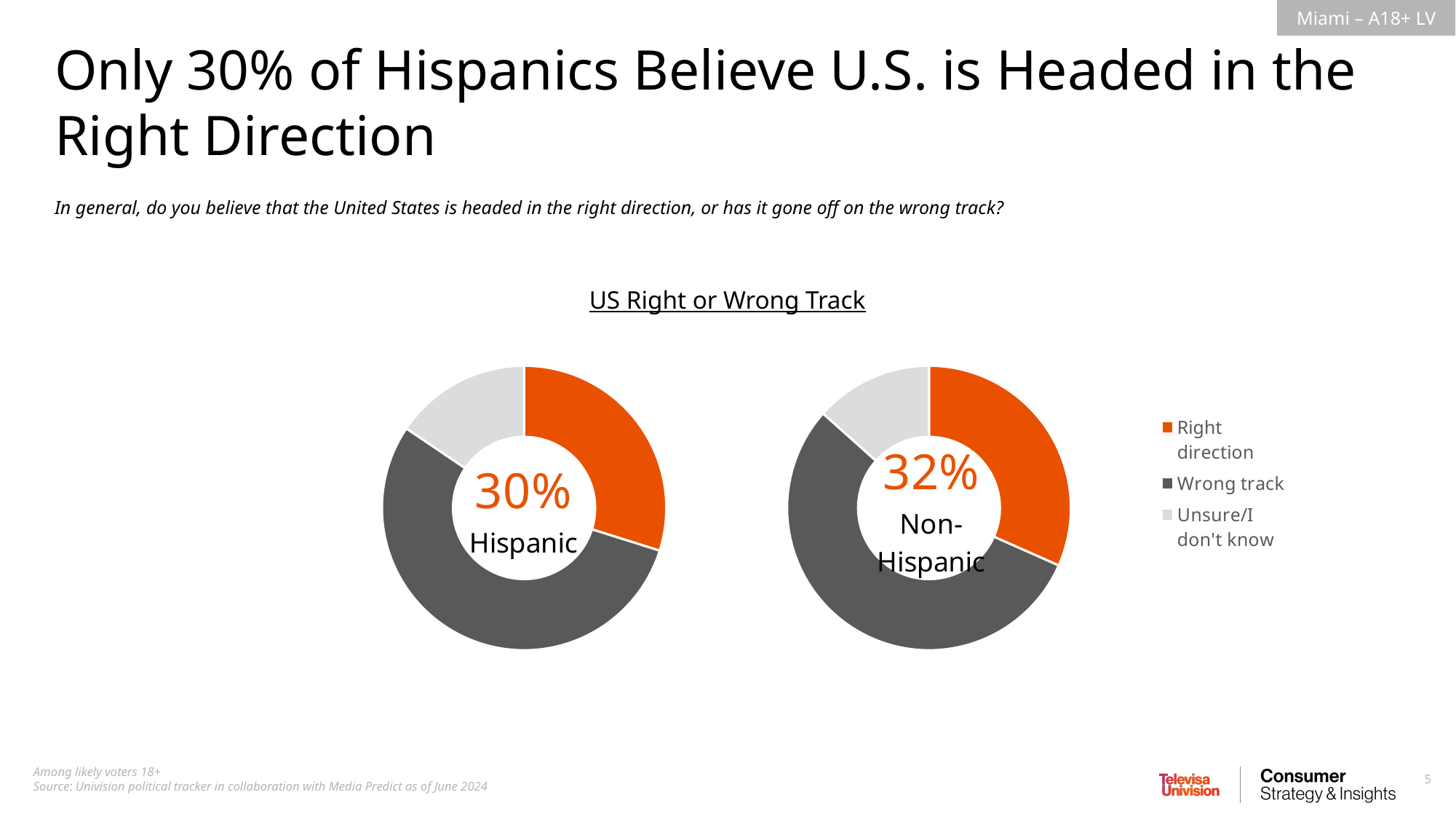
In the Non-Hispanic donut chart, what percentage chose Right direction? 32% How many donut charts are shown on the slide? 2 In the Non-Hispanic donut chart, which response takes up the largest slice? Wrong track How many response categories does the legend list? 3 What kind of chart is used to show the US Right or Wrong Track results? Pie (donut) chart Which colour represents Right direction in the donut charts? Orange In the Hispanic donut chart, which response takes up the smallest slice? Unsure/I don't know In the Hispanic donut chart, which response takes up the largest slice? Wrong track In the Hispanic donut chart, what percentage chose Right direction? 30% Which group has the higher Right direction share, Hispanic or Non-Hispanic? Non-Hispanic What is the title shown above the two donut charts? US Right or Wrong Track What is the difference in percentage points between the Non-Hispanic and Hispanic Right direction shares? 2 percentage points